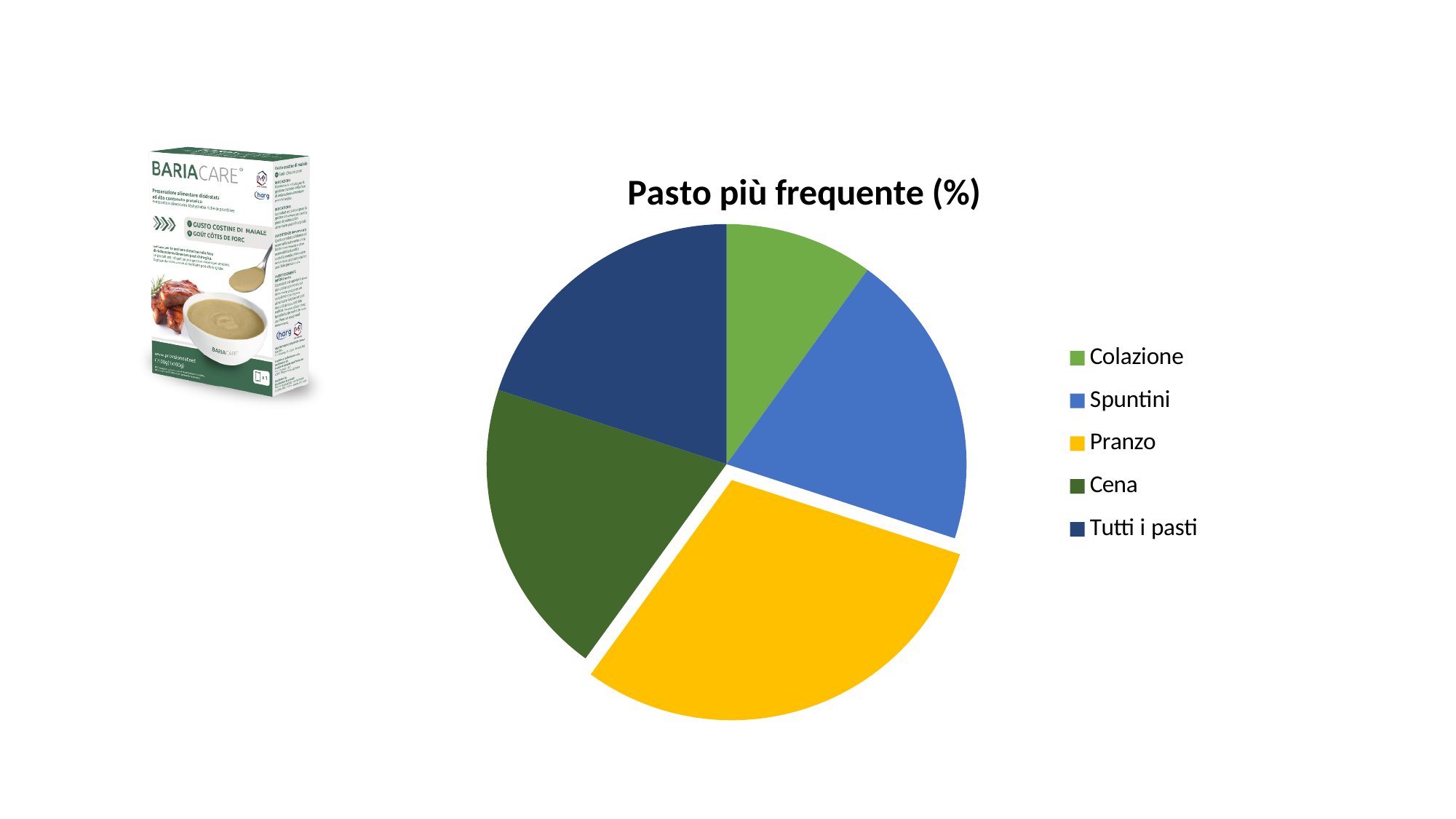
How many slices does the pie chart have? 5 Which category has the smallest slice in the pie chart? Colazione Which slice is larger, Pranzo or Spuntini? Pranzo Which category has the largest slice in the pie chart? Pranzo What is the title of the chart? Pasto più frequente (%) What kind of chart is shown on the slide? pie chart Which slice is larger, Tutti i pasti or Colazione? Tutti i pasti Which slice is larger, Spuntini or Colazione? Spuntini How many categories does the legend of the chart list? 5 Which category is shown in yellow in the pie chart? Pranzo